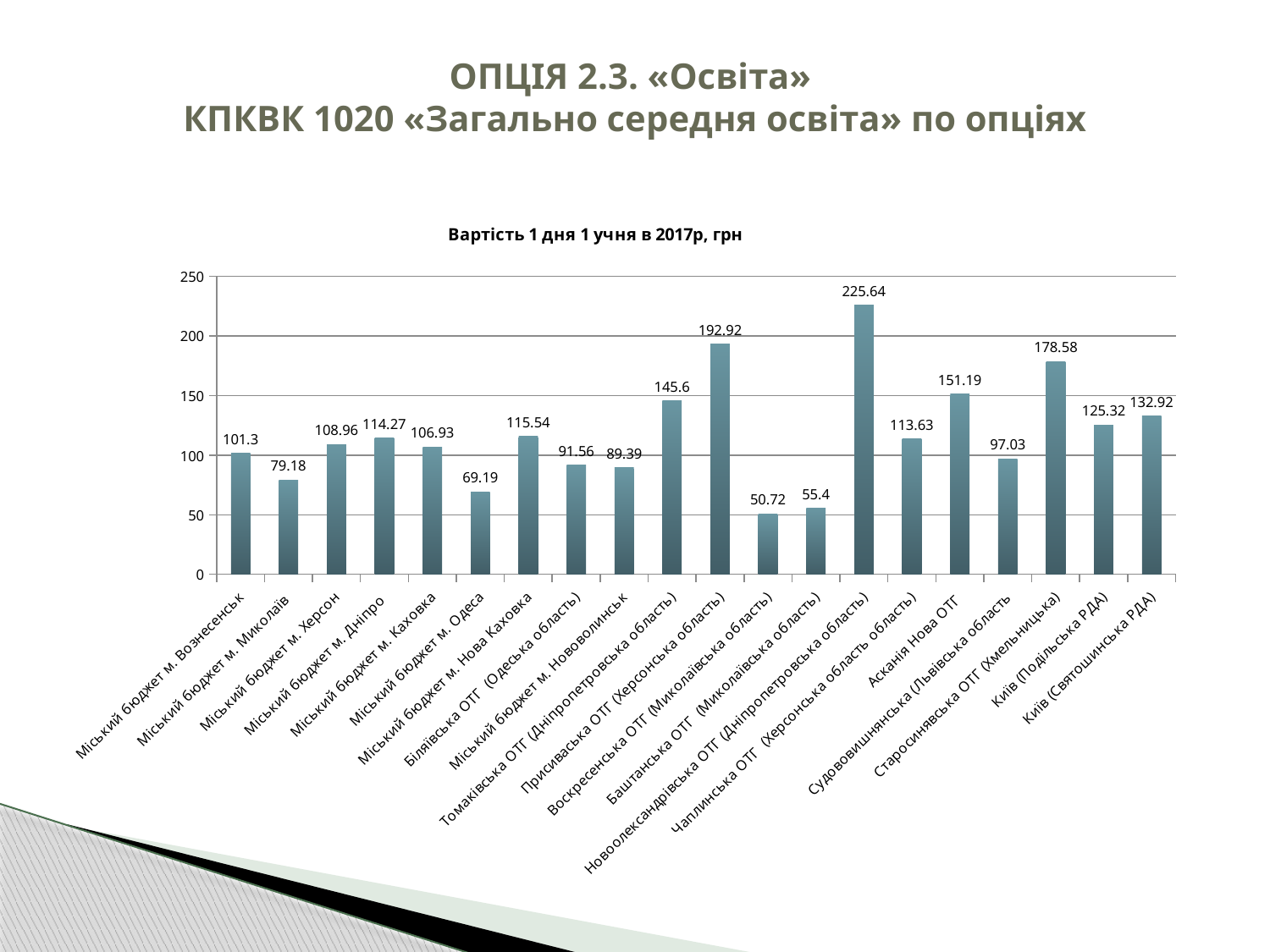
Which category has the lowest value? Воскресенська ОТГ (Миколаївська область) What kind of chart is shown on the slide? bar chart What is the title of the chart? Вартість 1 дня 1 учня в 2017р, грн Which is larger, the value for Міський бюджет м. Херсон or the value for Міський бюджет м. Дніпро? Міський бюджет м. Дніпро Which category has the highest value? Новоолександрівська ОТГ (Дніпропетровська область) What is the value for Міський бюджет м. Одеса? 69.19 What is the difference between the values for Присиваська ОТГ (Херсонська область) and Томаківська ОТГ (Дніпропетровська область)? 47.32 Is the value for Старосинявська ОТГ (Хмельницька) greater or less than 150? greater What is the value for Асканія Нова ОТГ? 151.19 What is the value for Київ (Святошинська РДА)? 132.92 How many categories are shown on the x axis? 20 What is the difference between the values for Київ (Святошинська РДА) and Київ (Подільська РДА)? 7.6